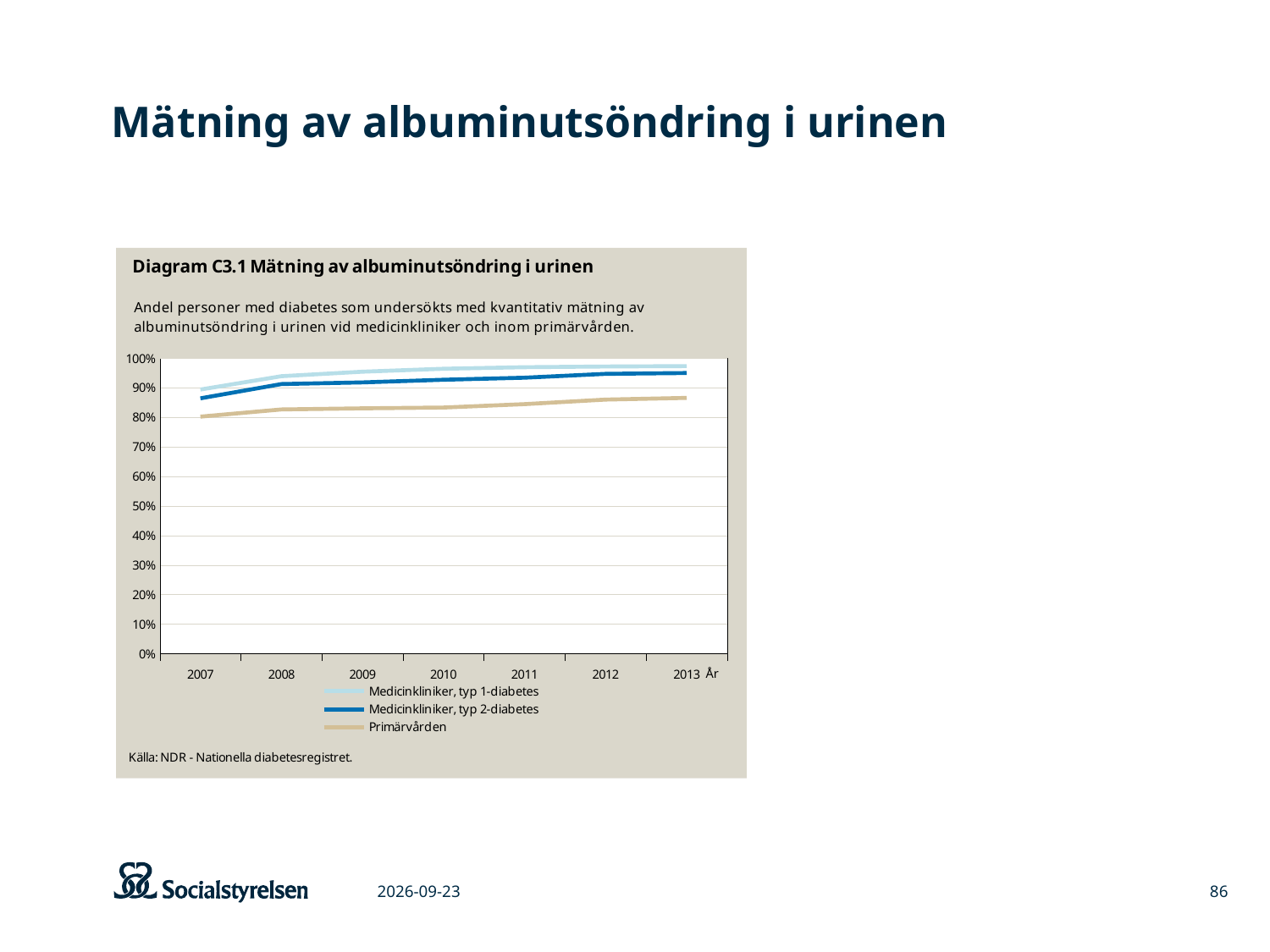
What is the title of the diagram on the slide? Diagram C3.1 Mätning av albuminutsöndring i urinen Is the value for Primärvården in 2007 greater or less than 90%? less Does the value for Primärvården rise or fall from 2007 to 2013? rise How many years are plotted along the x axis of the chart? 7 In 2010, which is larger: the value for Medicinkliniker, typ 2-diabetes or the value for Primärvården? Medicinkliniker, typ 2-diabetes Is the value for Medicinkliniker, typ 2-diabetes in 2013 greater or less than 90%? greater What source is cited below the chart? NDR - Nationella diabetesregistret How many series does the legend of the chart list? 3 Which series has the highest values across all years in the chart? Medicinkliniker, typ 1-diabetes What kind of chart is shown in Diagram C3.1? line chart Which series has the lowest values across all years in the chart? Primärvården Is the value for Medicinkliniker, typ 1-diabetes in 2007 greater or less than 80%? greater